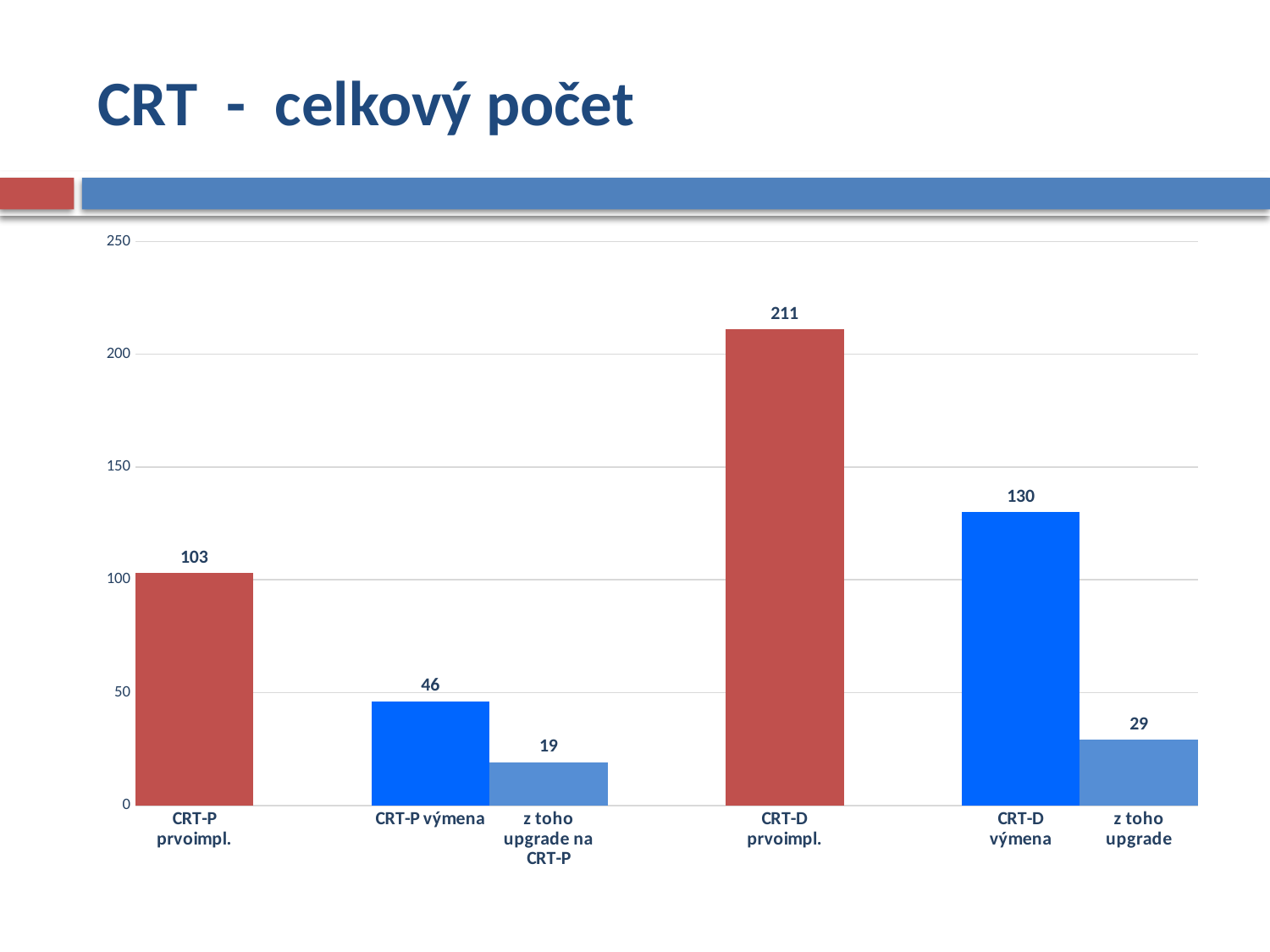
Which is larger, CRT-P výmena or z toho upgrade? CRT-P výmena What is the difference between CRT-D prvoimpl. and CRT-P prvoimpl.? 108 Which category has the highest value? CRT-D prvoimpl. What kind of chart is shown on the slide? bar chart How many bars are shown in the chart? 6 Is the value for CRT-D prvoimpl. greater or less than 200? greater Which category has the lowest value? z toho upgrade na CRT-P What is the value for CRT-P prvoimpl.? 103 What is the value for CRT-D výmena? 130 What is the title of the slide? CRT - celkový počet What is the value for z toho upgrade na CRT-P? 19 What is the difference between CRT-D výmena and CRT-P výmena? 84